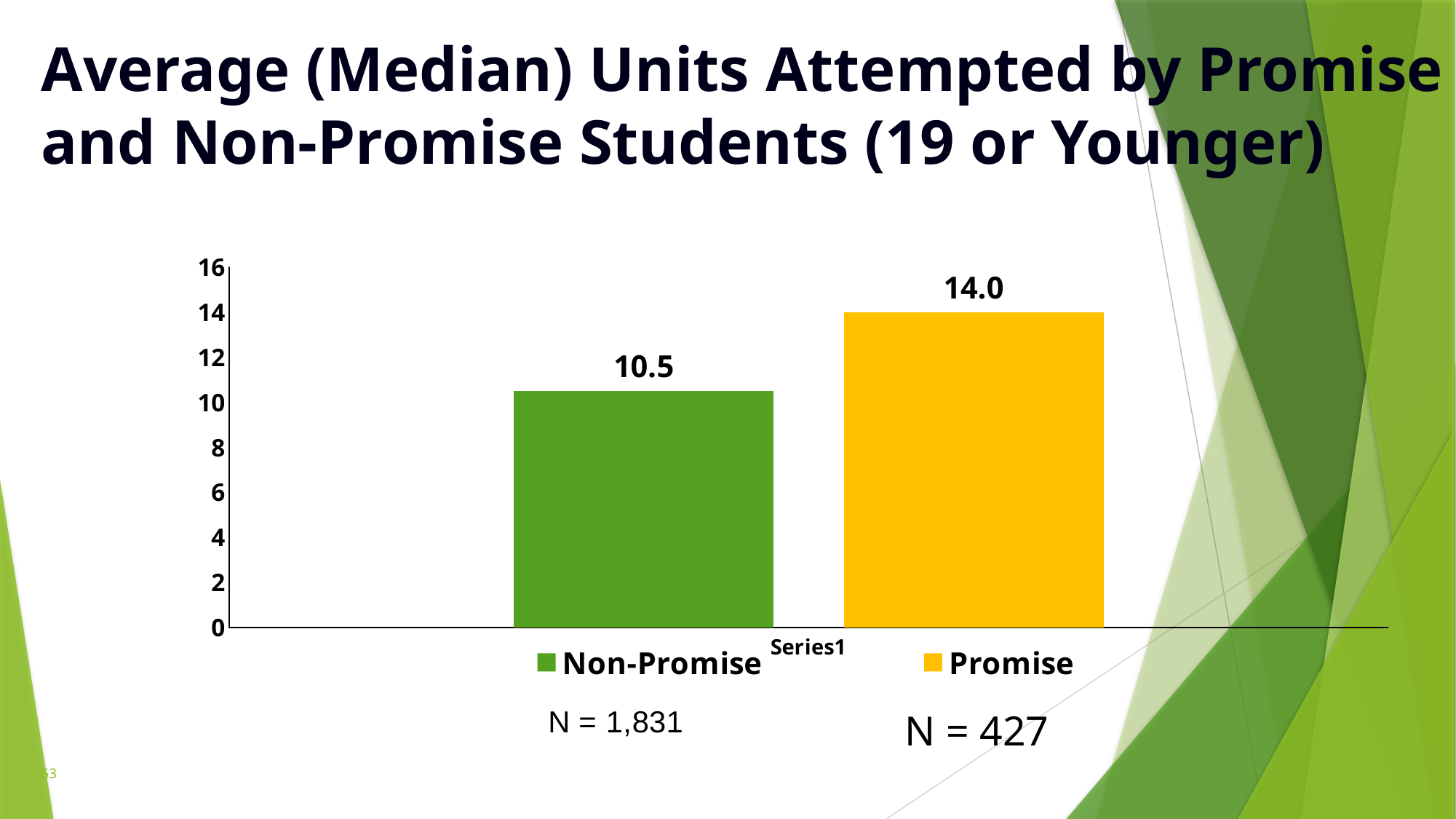
Is the value for Promise students greater or less than 12? greater What is the median units attempted for Non-Promise students? 10.5 What is the median units attempted for Promise students? 14.0 Is the value for Non-Promise students greater or less than 12? less What is the difference in median units attempted between Promise and Non-Promise students? 3.5 How many series does the legend list? 2 What kind of chart is shown on the slide? Bar chart Which group has the lower median units attempted? Non-Promise How many bars are plotted in the chart? 2 Which group has the higher median units attempted? Promise What colour is the bar for Promise students? Yellow What is the maximum value shown on the vertical axis? 16